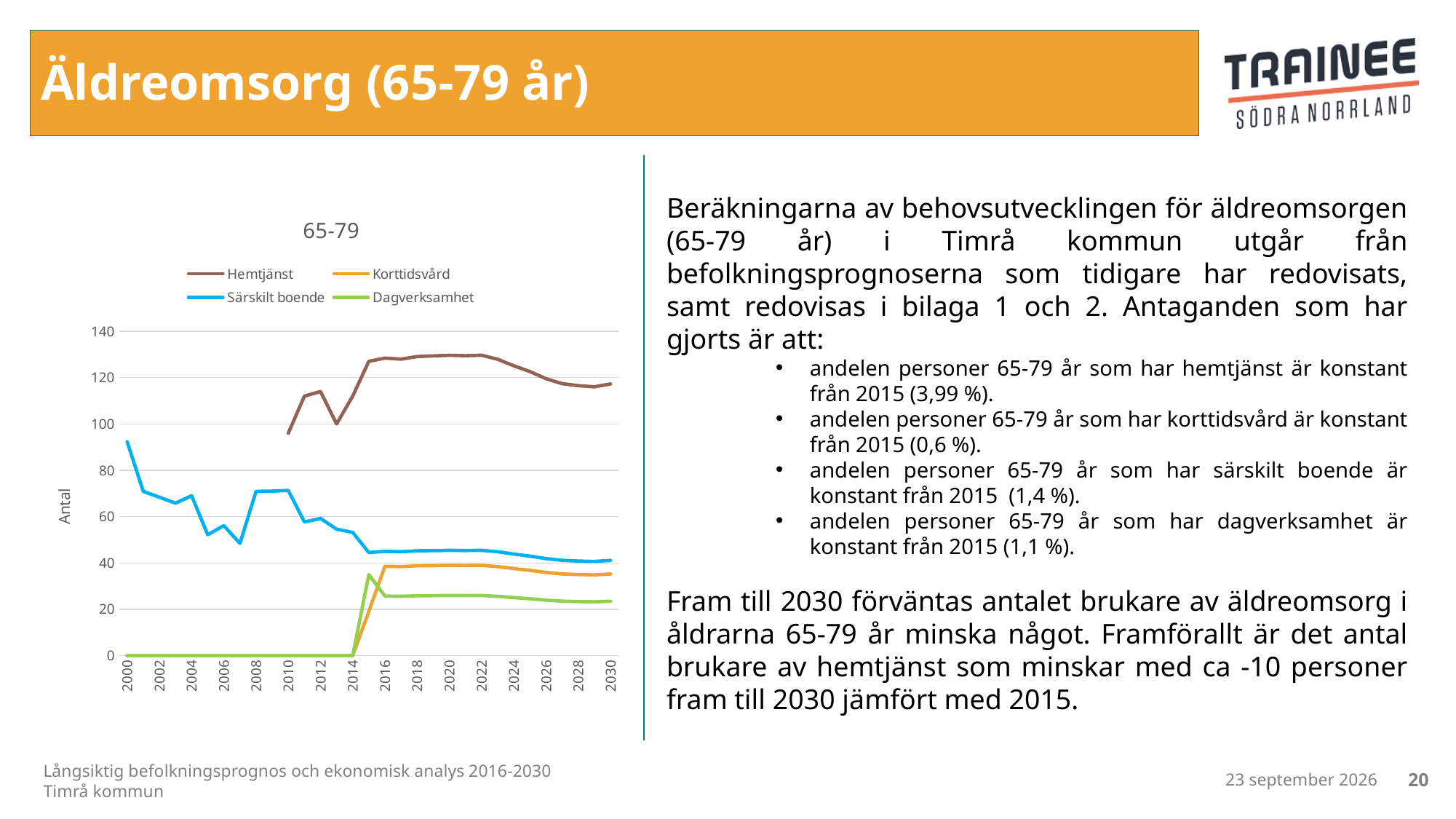
Is the value for Dagverksamhet in 2030 greater or less than 40? less How many series does the chart legend list? 4 Which series are listed in the chart legend? Hemtjänst, Korttidsvård, Särskilt boende, Dagverksamhet Which series has the lowest value in 2030? Dagverksamhet Is the value for Korttidsvård in 2010 greater or less than 20? less What kind of chart is shown on the slide? Line chart Which series has the highest value in 2030? Hemtjänst In 2030, which is higher: Korttidsvård or Dagverksamhet? Korttidsvård What is the title of the chart? 65-79 Is the value for Särskilt boende in 2000 greater or less than 80? greater Does the Särskilt boende line rise or fall between 2000 and 2014? Falls